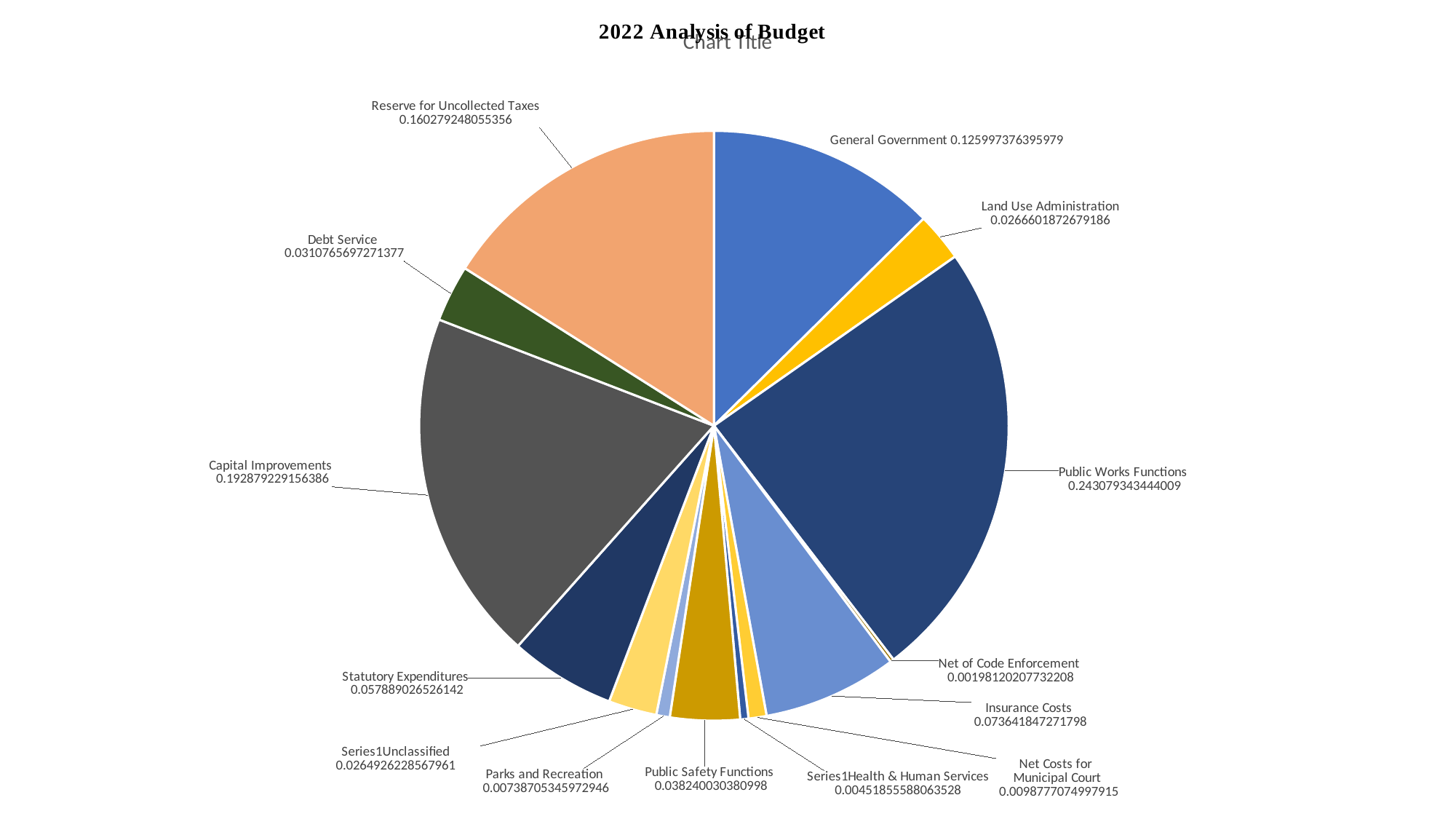
Which category has the smallest slice of the pie? Net of Code Enforcement What is the value shown for Reserve for Uncollected Taxes? 0.160279248055356 Which is larger, Capital Improvements or Reserve for Uncollected Taxes? Capital Improvements What is the value shown for General Government? 0.125997376395979 What is the value shown for Debt Service? 0.0310765697271377 What is the value shown for Insurance Costs? 0.073641847271798 Which category has the largest slice of the pie? Public Works Functions What kind of chart is shown on the slide? Pie chart What is the value shown for Capital Improvements? 0.192879229156386 How many slices does the pie chart have? 14 Which is larger, Statutory Expenditures or Public Safety Functions? Statutory Expenditures What is the title of the chart shown in bold at the top of the slide? 2022 Analysis of Budget